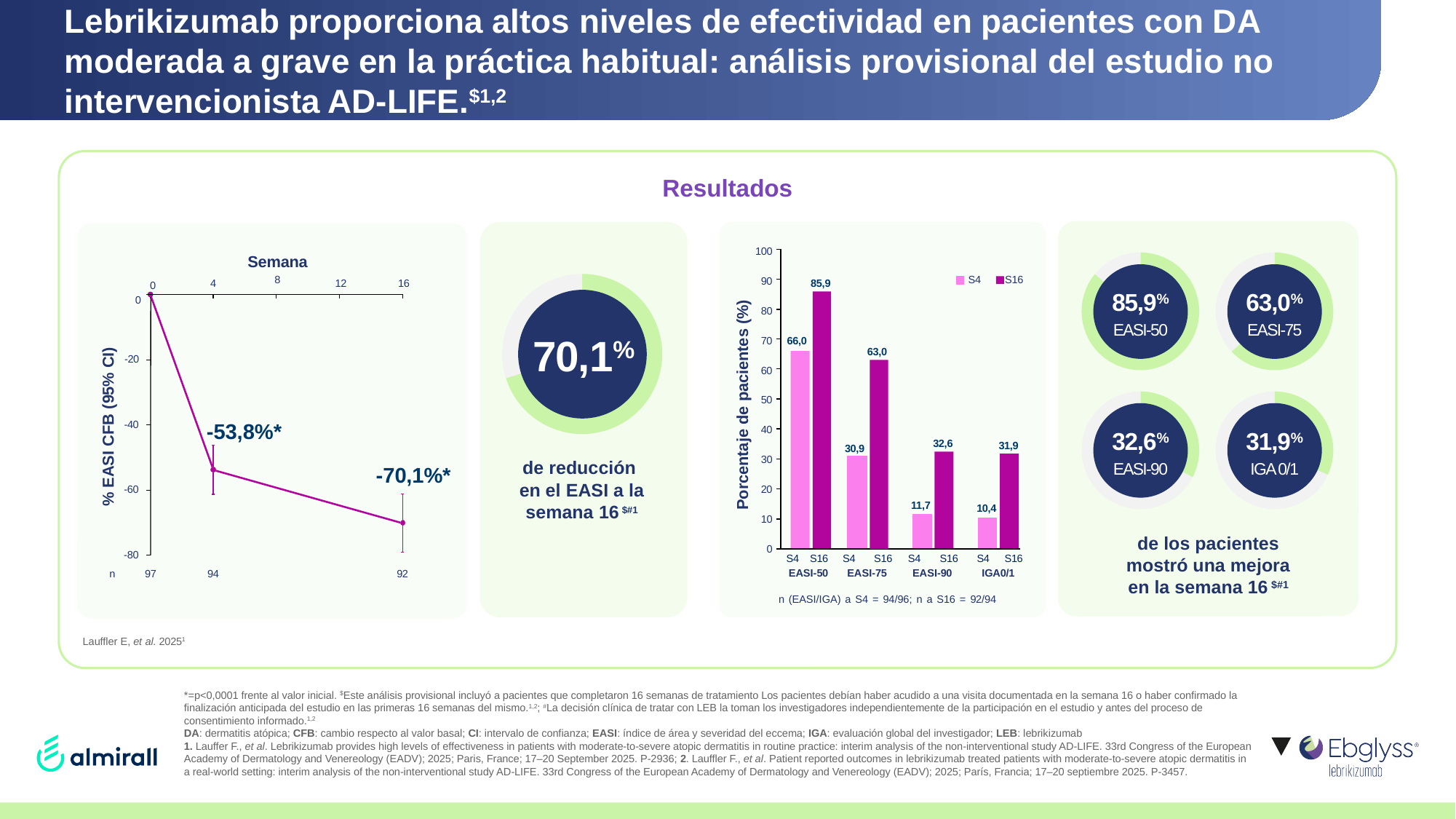
What kind of chart is the chart on the left showing % EASI CFB over Semana? Line chart In the bar chart on the right, what is the value for EASI-50 at S16? 85,9 In the bar chart on the right, which category has the lowest S4 value? IGA0/1 In the bar chart on the right, what is the value for EASI-90 at S4? 11,7 In the bar chart on the right, which category has the highest S16 value? EASI-50 In the line chart on the left, do the values rise or fall from week 0 to week 16? Fall In the bar chart on the right, what is the value for IGA0/1 at S16? 31,9 In the bar chart on the right, what is the difference between the S16 and S4 values for EASI-75? 32,1 In the bar chart on the right, which is larger: the S4 value for EASI-50 or the S16 value for EASI-75? S4 value for EASI-50 In the line chart on the left, what is the value labelled at week 16? -70,1%* How many categories are shown on the x axis of the bar chart on the right? 4 How many series does the legend of the bar chart on the right list? 2